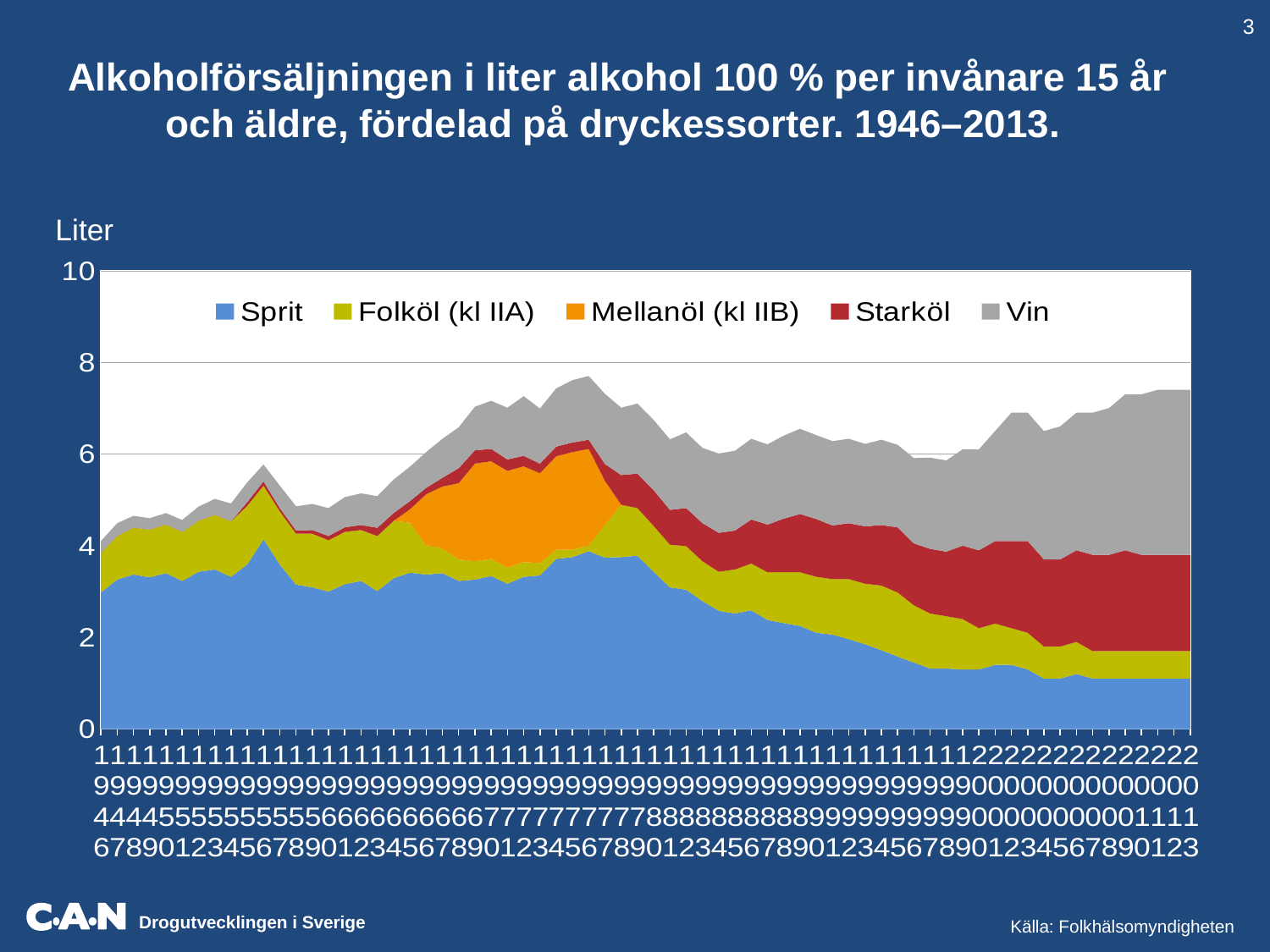
Is the total stacked value in 1946 greater or less than 6? less Which series has the largest value in 2013? Vin What are the series listed in the legend? Sprit, Folköl (kl IIA), Mellanöl (kl IIB), Starköl, Vin Does the value for Sprit rise or fall from 1946 to 2013? fall How many series does the legend list? 5 In 2013, which is larger, Vin or Sprit? Vin What is the label on the vertical axis? Liter Is the value for Sprit in 1946 greater or less than 2? greater Which series has the largest value in 1946? Sprit Is the total stacked value in 2013 greater or less than 6? greater What kind of chart is shown on the slide? Stacked area chart